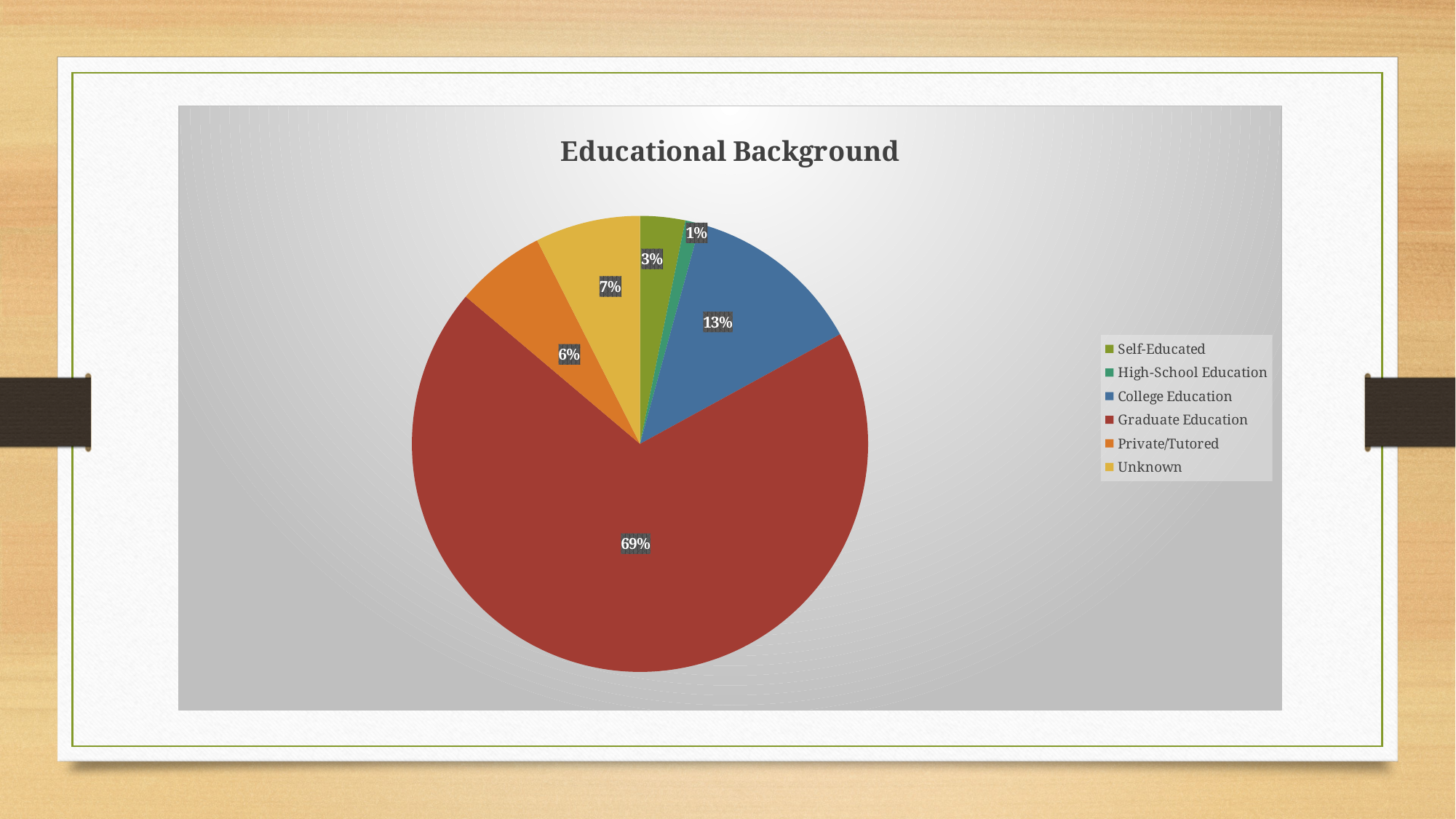
What is the value shown for Self-Educated? 3% What share of the pie does Graduate Education represent? 69% How many categories does the legend list? 6 Which category has the smallest slice of the pie? High-School Education What is the value shown for High-School Education? 1% What is the value shown for Private/Tutored? 6% What is the difference between the Graduate Education and College Education shares? 56% What is the title of the chart? Educational Background What is the value shown for Unknown? 7% What share of the pie does College Education represent? 13% Which category has the largest slice of the pie? Graduate Education What type of chart is shown on the slide? Pie chart